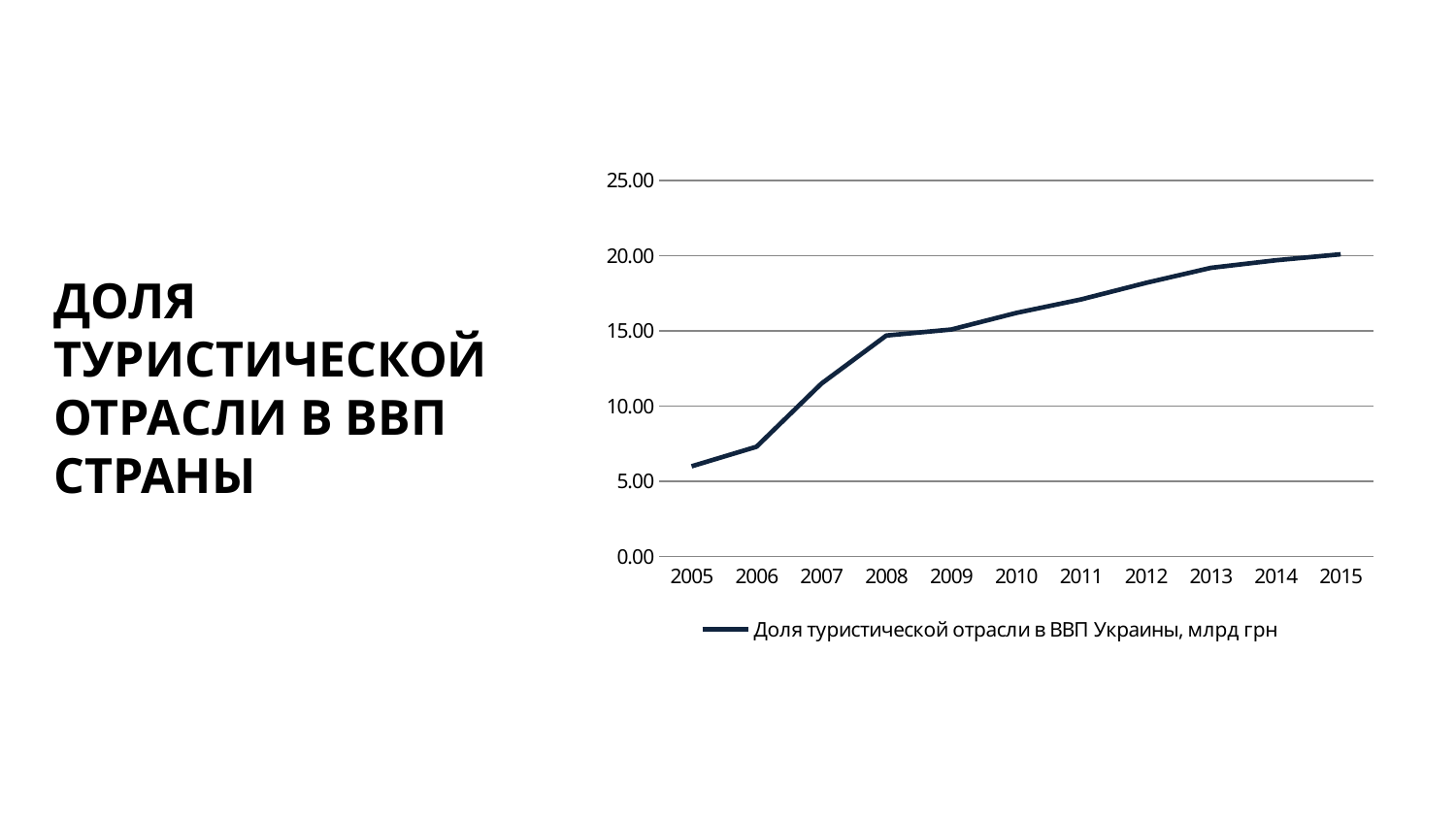
What kind of chart is shown on the slide? line chart Is the value for 2010 greater or less than 15.00? greater Which year has the highest value on the chart? 2015 Is the value for 2005 greater or less than 10.00? less Which year has the larger value, 2006 or 2009? 2009 Do the values rise or fall from 2005 to 2015? rise Is the value for 2007 greater or less than 10.00? greater Which year has the lowest value on the chart? 2005 How many series does the chart's legend list? 1 How many years are plotted on the x axis of the chart? 11 What is the legend entry for the series plotted on the chart? Доля туристической отрасли в ВВП Украины, млрд грн